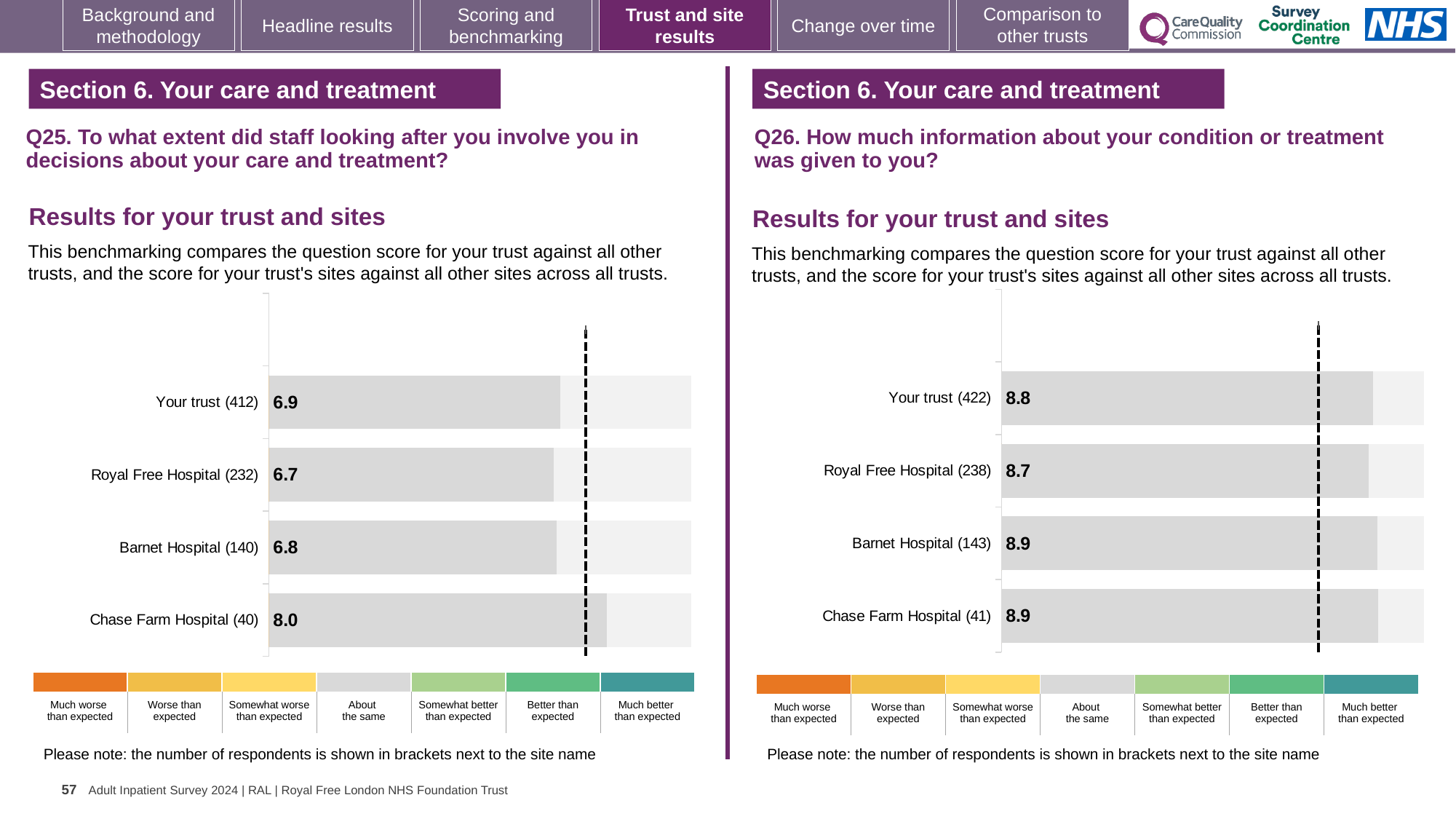
What kind of chart is used for the Q26 results on the right? Bar chart In the Q25 chart on the left, which site or trust has the highest score? Chase Farm Hospital In the Q26 chart on the right, what is the score for Your trust? 8.8 In the Q25 chart on the left, what is the score for Chase Farm Hospital? 8.0 In the Q25 chart on the left, what is the difference between the scores for Chase Farm Hospital and Your trust? 1.1 In the Q25 chart on the left, how many bars are plotted? 4 In the Q26 chart on the right, what is the score for Barnet Hospital? 8.9 In the Q25 chart on the left, what is the score for Royal Free Hospital? 6.7 In the Q25 chart on the left, which site or trust has the lowest score? Royal Free Hospital In the Q26 chart on the right, how many respondents are shown in brackets for Chase Farm Hospital? 41 In the Q26 chart on the right, which site or trust has the lowest score? Royal Free Hospital In the Q26 chart on the right, which has the larger score, Your trust or Royal Free Hospital? Your trust